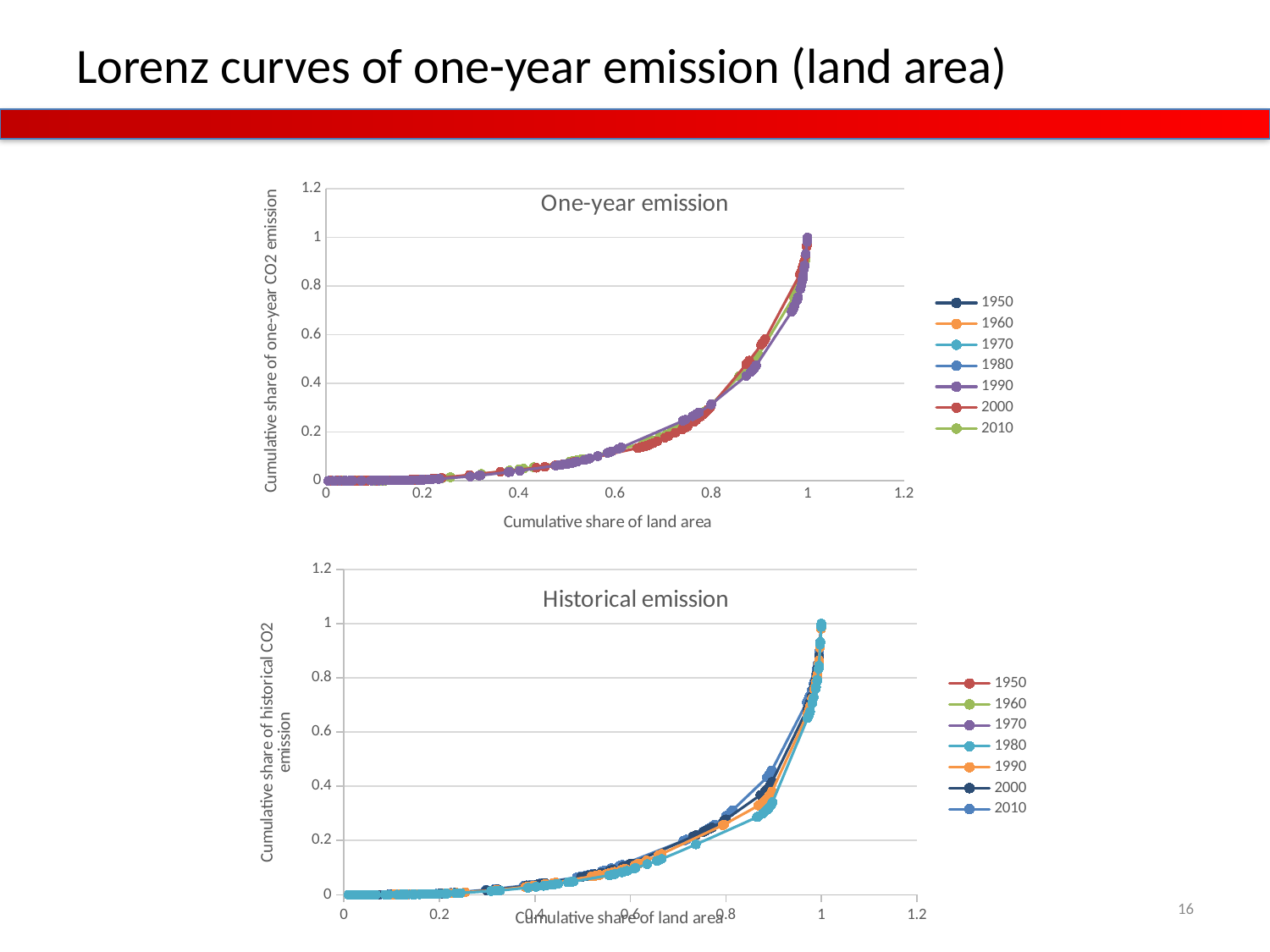
What type of chart is the top chart titled "One-year emission"? line chart In the top chart "One-year emission", do the curves rise or fall as the cumulative share of land area increases? rise In the top chart "One-year emission", at a cumulative share of land area of 0.6, is the cumulative share of emission greater or less than 0.2? less What type of chart is the bottom chart titled "Historical emission"? line chart Which years are listed in the legend of the bottom chart "Historical emission"? 1950, 1960, 1970, 1980, 1990, 2000, 2010 What is the x-axis label of the top chart "One-year emission"? Cumulative share of land area In the top chart "One-year emission", at a cumulative share of land area of 1, is the cumulative share of emission greater or less than 0.8? greater In the bottom chart "Historical emission", how many series does the legend list? 7 In the top chart "One-year emission", how many series does the legend list? 7 In the bottom chart "Historical emission", at a cumulative share of land area of 0.8, is the cumulative share of emission greater or less than 0.6? less In the bottom chart "Historical emission", do the curves rise or fall along the x axis? rise